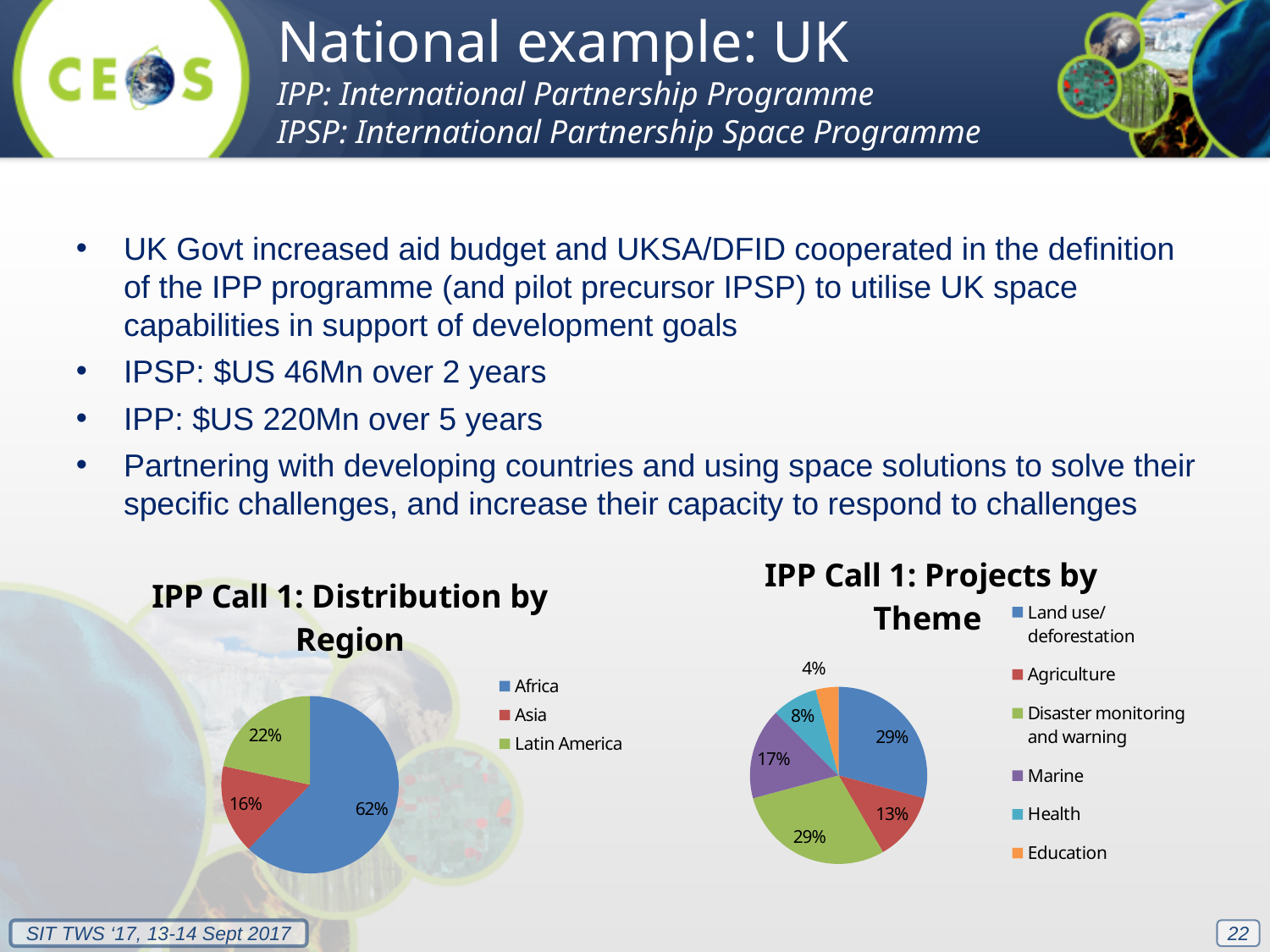
In the 'IPP Call 1: Projects by Theme' chart, what share does Agriculture have? 13% In the 'IPP Call 1: Distribution by Region' chart, what is the difference in percentage points between Latin America and Asia? 6 In the 'IPP Call 1: Projects by Theme' chart, what is the difference in percentage points between Land use/deforestation and Health? 21 In the 'IPP Call 1: Projects by Theme' chart, which is larger, Health or Marine? Marine What kind of chart is 'IPP Call 1: Distribution by Region'? Pie chart In the 'IPP Call 1: Distribution by Region' chart, what share does Africa have? 62% In the 'IPP Call 1: Projects by Theme' chart, which theme has the smallest share? Education In the 'IPP Call 1: Projects by Theme' chart, what share does Marine have? 17% How many themes are listed in the legend of the 'IPP Call 1: Projects by Theme' chart? 6 In the 'IPP Call 1: Distribution by Region' chart, which region has the smallest share? Asia In the 'IPP Call 1: Distribution by Region' chart, which region has the largest share? Africa In the 'IPP Call 1: Distribution by Region' chart, what share does Asia have? 16%